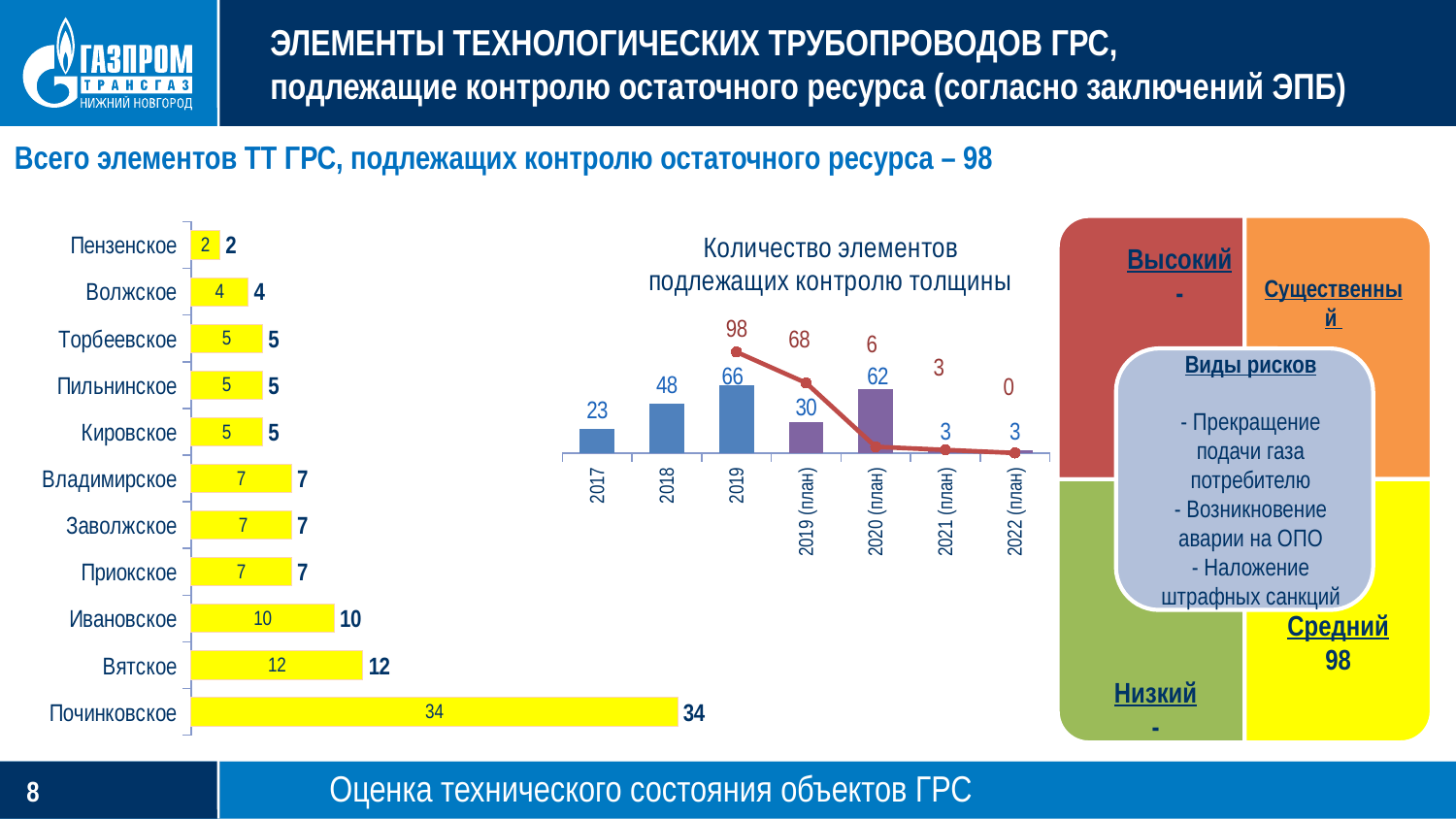
In the left bar chart, what is the value for Починковское? 34 In the left bar chart, which category has the lowest value? Пензенское How many categories are shown in the left bar chart? 11 In the left bar chart, which category has the highest value? Починковское In the left bar chart, what is the difference between the values for Починковское and Вятское? 22 In the chart titled 'Количество элементов подлежащих контролю толщины', what is the difference between the bar values for 2018 and 2017? 25 In the chart titled 'Количество элементов подлежащих контролю толщины', how many x-axis categories are shown? 7 In the left bar chart, which is larger, the value for Ивановское or the value for Волжское? Ивановское What kind of chart is the chart on the left of the slide? Bar chart In the chart titled 'Количество элементов подлежащих контролю толщины', what is the bar value for 2019? 66 In the left bar chart, what is the value for Вятское? 12 In the chart titled 'Количество элементов подлежащих контролю толщины', what is the bar value for 2018? 48